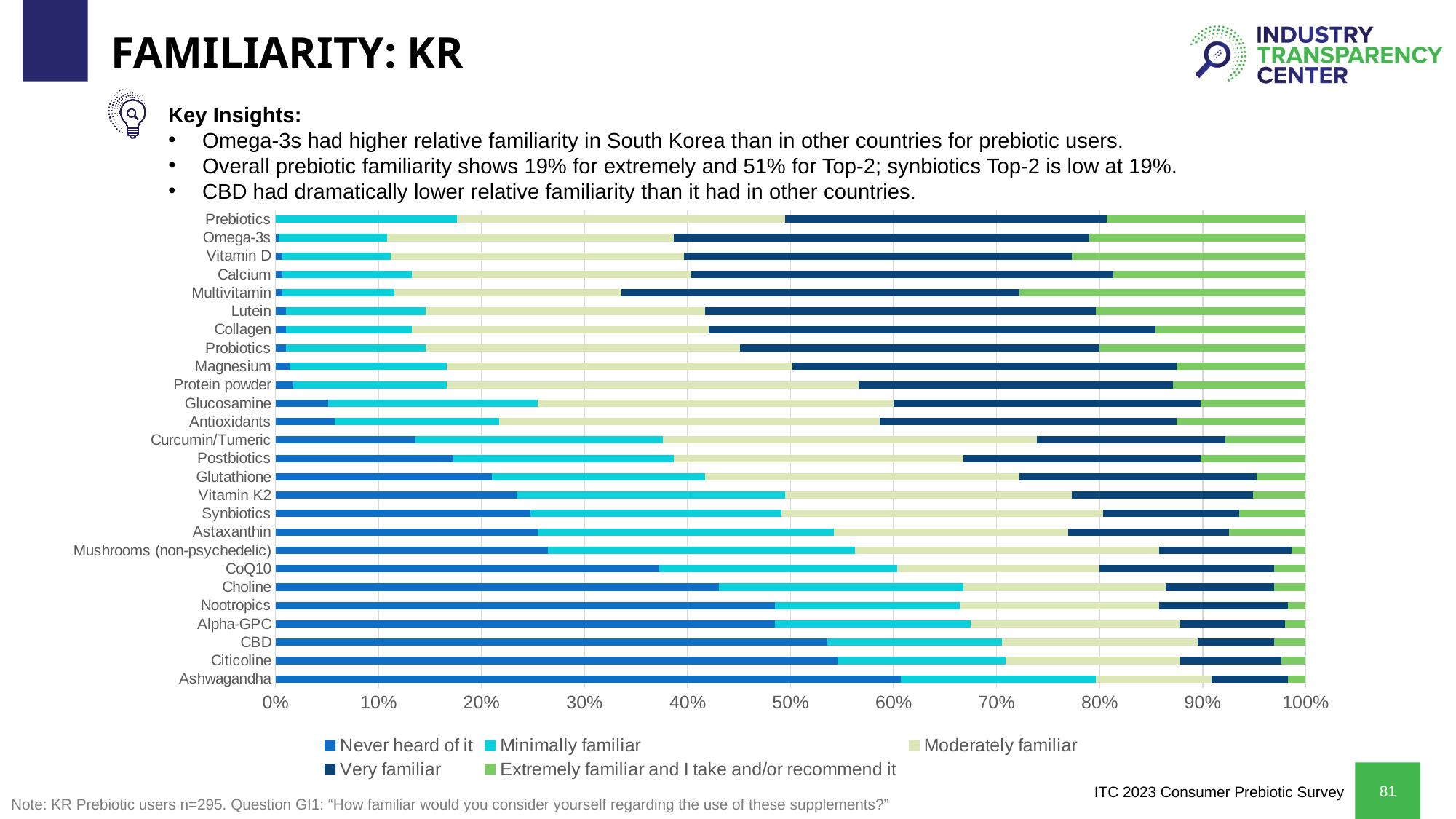
What is the label of the last legend entry? Extremely familiar and I take and/or recommend it Which category has the largest 'Never heard of it' segment? Ashwagandha Is the 'Never heard of it' value for Ashwagandha greater or less than 50%? greater What type of chart is shown on the slide? Stacked bar chart Is the 'Never heard of it' value for Postbiotics greater or less than 20%? less How many series does the chart legend list? 5 Is the 'Never heard of it' value for Citicoline greater or less than 50%? greater Which has a larger 'Never heard of it' segment, Choline or CoQ10? Choline How many supplement categories are listed on the chart? 26 Which category appears at the top of the chart? Prebiotics